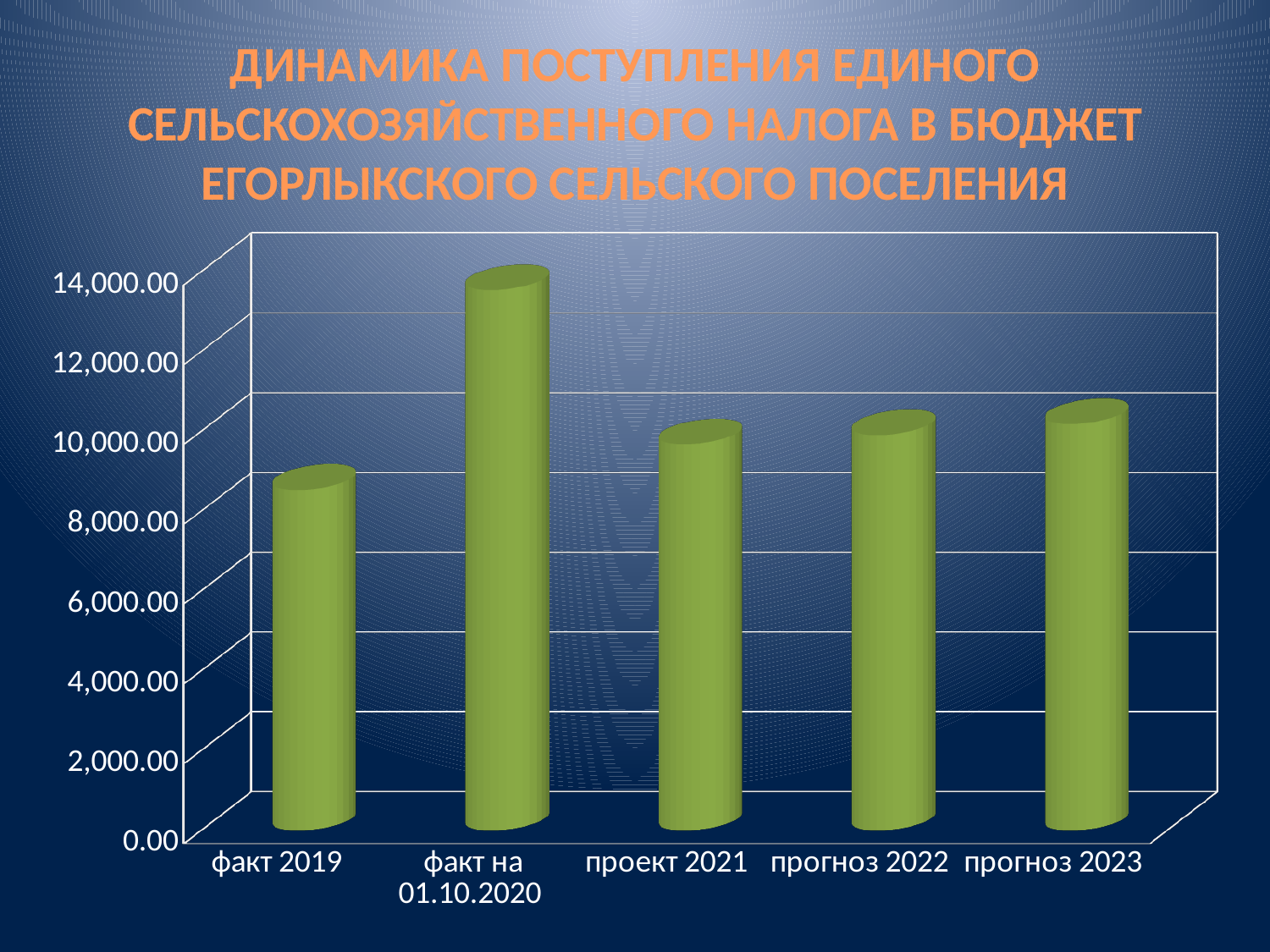
What is the highest tick value shown on the vertical axis? 14,000.00 Is the value for факт 2019 greater or less than 6,000.00? greater Is the value for факт 2019 greater or less than 10,000.00? less Which category has the lowest value? факт 2019 Is the value for прогноз 2023 greater or less than 8,000.00? greater Which is larger, the value for факт 2019 or the value for прогноз 2023? прогноз 2023 How many categories are plotted on the x axis? 5 Which is larger, the value for факт на 01.10.2020 or the value for проект 2021? факт на 01.10.2020 What is the title of the chart? ДИНАМИКА ПОСТУПЛЕНИЯ ЕДИНОГО СЕЛЬСКОХОЗЯЙСТВЕННОГО НАЛОГА В БЮДЖЕТ ЕГОРЛЫКСКОГО СЕЛЬСКОГО ПОСЕЛЕНИЯ Which category has the highest value? факт на 01.10.2020 What kind of chart is shown on the slide? bar chart